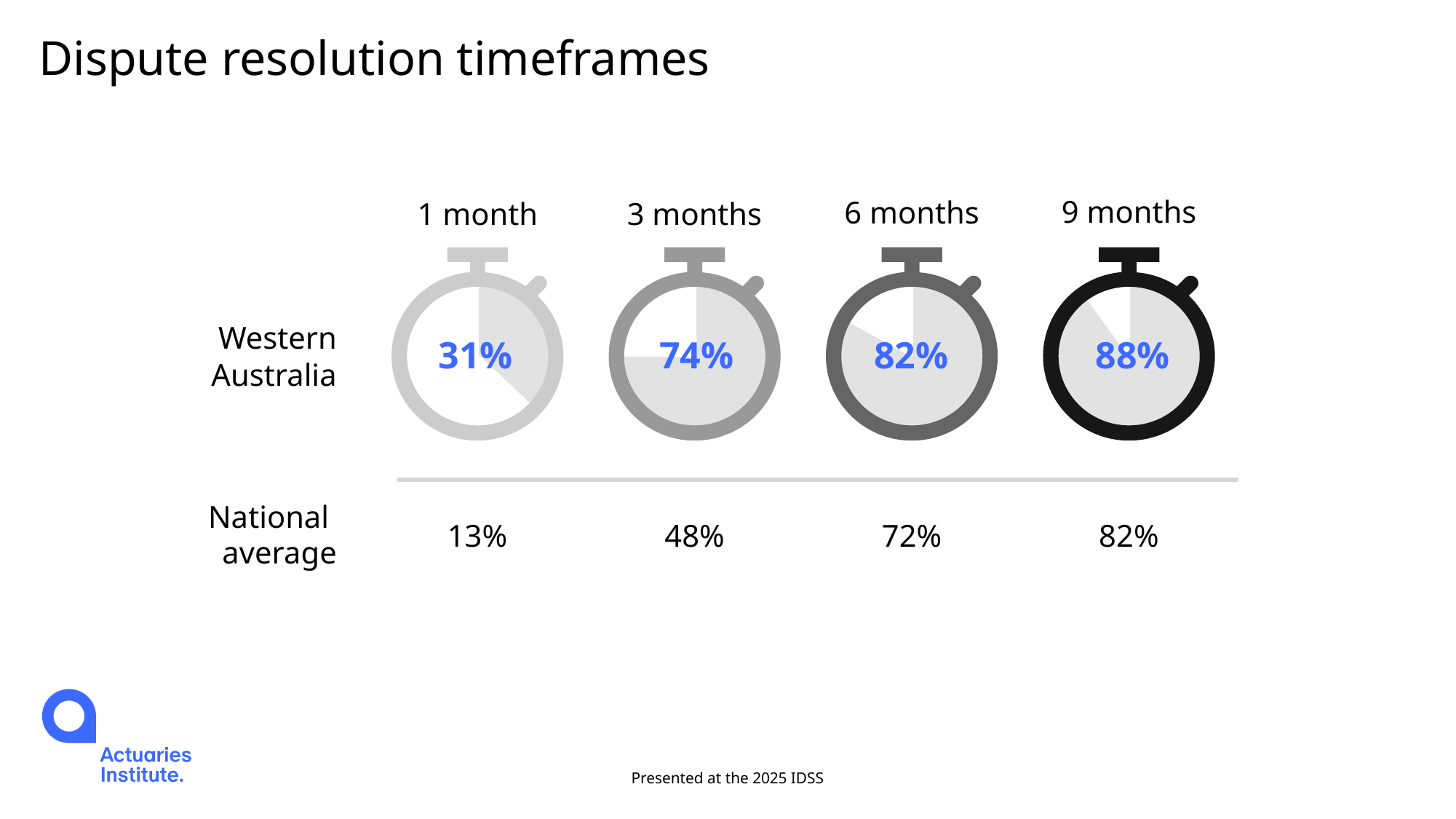
What is the title of the slide? Dispute resolution timeframes What is the difference between the Western Australia value and the national average at 1 month? 18% What is the Western Australia value at 6 months? 82% Which is larger at 6 months: the Western Australia value or the national average? Western Australia What is the national average at 9 months? 82% Do the Western Australia values rise or fall as the timeframe increases from 1 month to 9 months? rise At which timeframe is the national average lowest? 1 month At which timeframe is the Western Australia value highest? 9 months What is the national average at 3 months? 48% What is the difference between the Western Australia value and the national average at 3 months? 26% How many timeframes are shown on the slide? 4 What percentage of disputes in Western Australia are resolved within 1 month? 31%